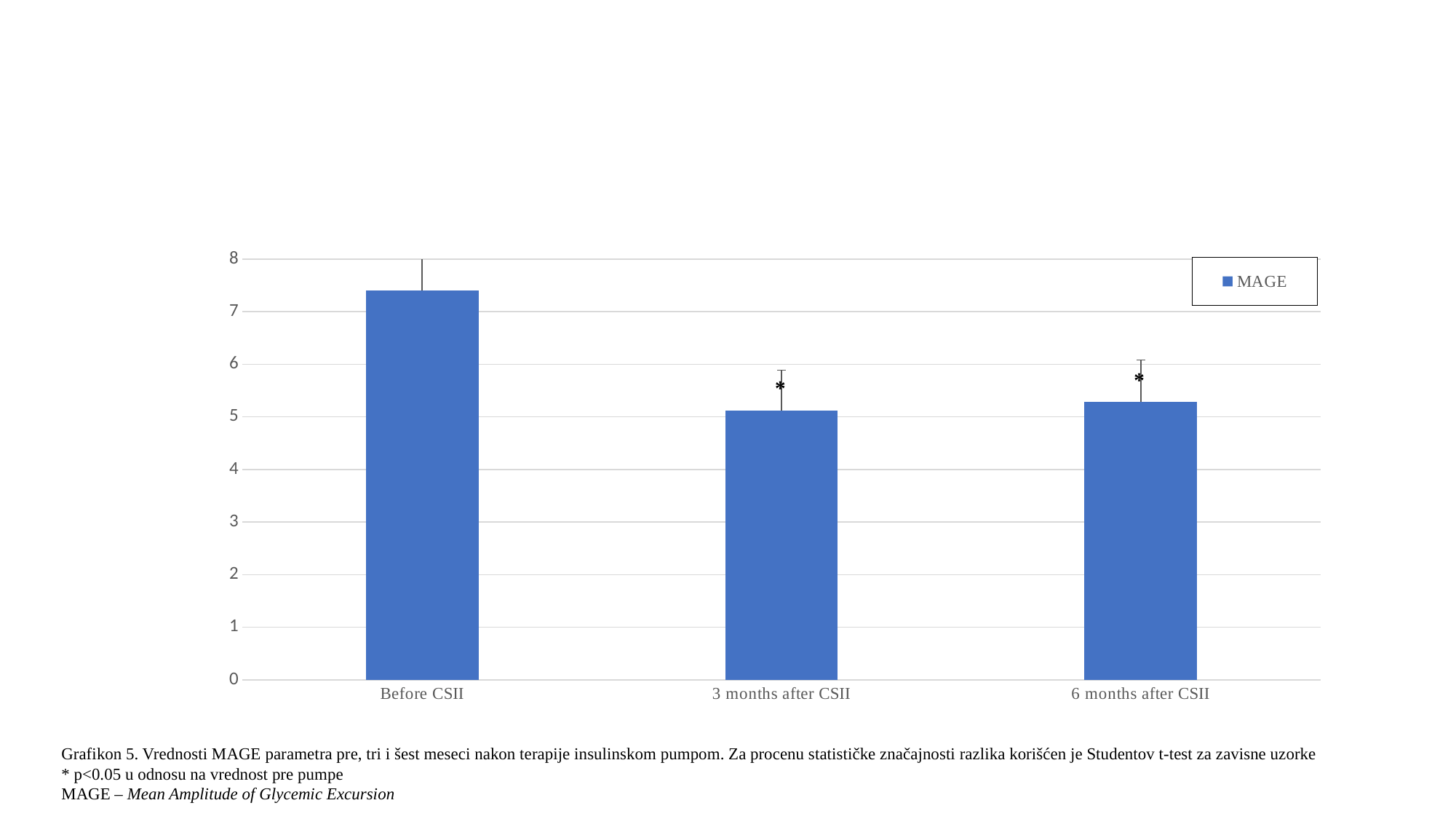
Is the MAGE value for Before CSII greater or less than 7? greater Which is larger, the MAGE value for Before CSII or for 6 months after CSII? Before CSII Which category has the highest MAGE value? Before CSII What series name is shown in the chart legend? MAGE Does the MAGE value rise or fall from Before CSII to 3 months after CSII? fall What kind of chart is shown on the slide? bar chart Is the MAGE value for 3 months after CSII greater or less than 6? less Is the MAGE value for 6 months after CSII greater or less than 5? greater Which is larger, the MAGE value for Before CSII or for 3 months after CSII? Before CSII How many categories are shown on the x axis of the chart? 3 How many series does the legend list? 1